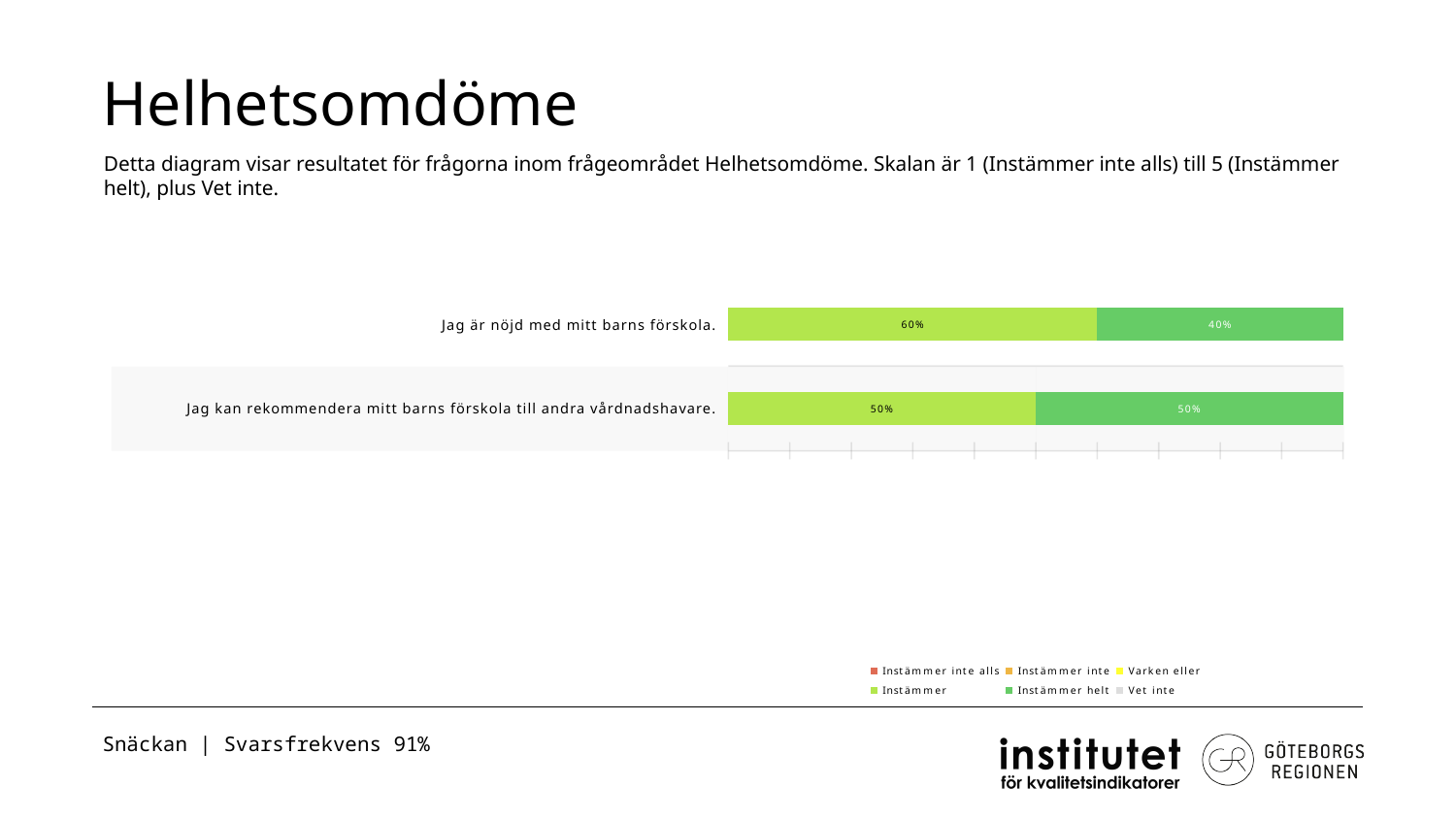
What is the value of the 'Instämmer' segment for 'Jag är nöjd med mitt barns förskola.'? 60% What is the value of the 'Instämmer' segment for 'Jag kan rekommendera mitt barns förskola till andra vårdnadshavare.'? 50% How many categories (statements) are plotted in the chart? 2 What is the value of the 'Instämmer helt' segment for 'Jag kan rekommendera mitt barns förskola till andra vårdnadshavare.'? 50% What kind of chart is shown on the slide? Stacked bar chart What is the title of the slide containing the chart? Helhetsomdöme How many series does the legend list? 6 What is the total of the two labelled segments in the bar for 'Jag är nöjd med mitt barns förskola.'? 100% What is the value of the 'Instämmer helt' segment for 'Jag är nöjd med mitt barns förskola.'? 40% Which statement has the larger 'Instämmer helt' share: 'Jag är nöjd med mitt barns förskola.' or 'Jag kan rekommendera mitt barns förskola till andra vårdnadshavare.'? Jag kan rekommendera mitt barns förskola till andra vårdnadshavare. What is the difference between the 'Instämmer' and 'Instämmer helt' segments for 'Jag är nöjd med mitt barns förskola.'? 20% Which statement has the highest 'Instämmer' value? Jag är nöjd med mitt barns förskola.